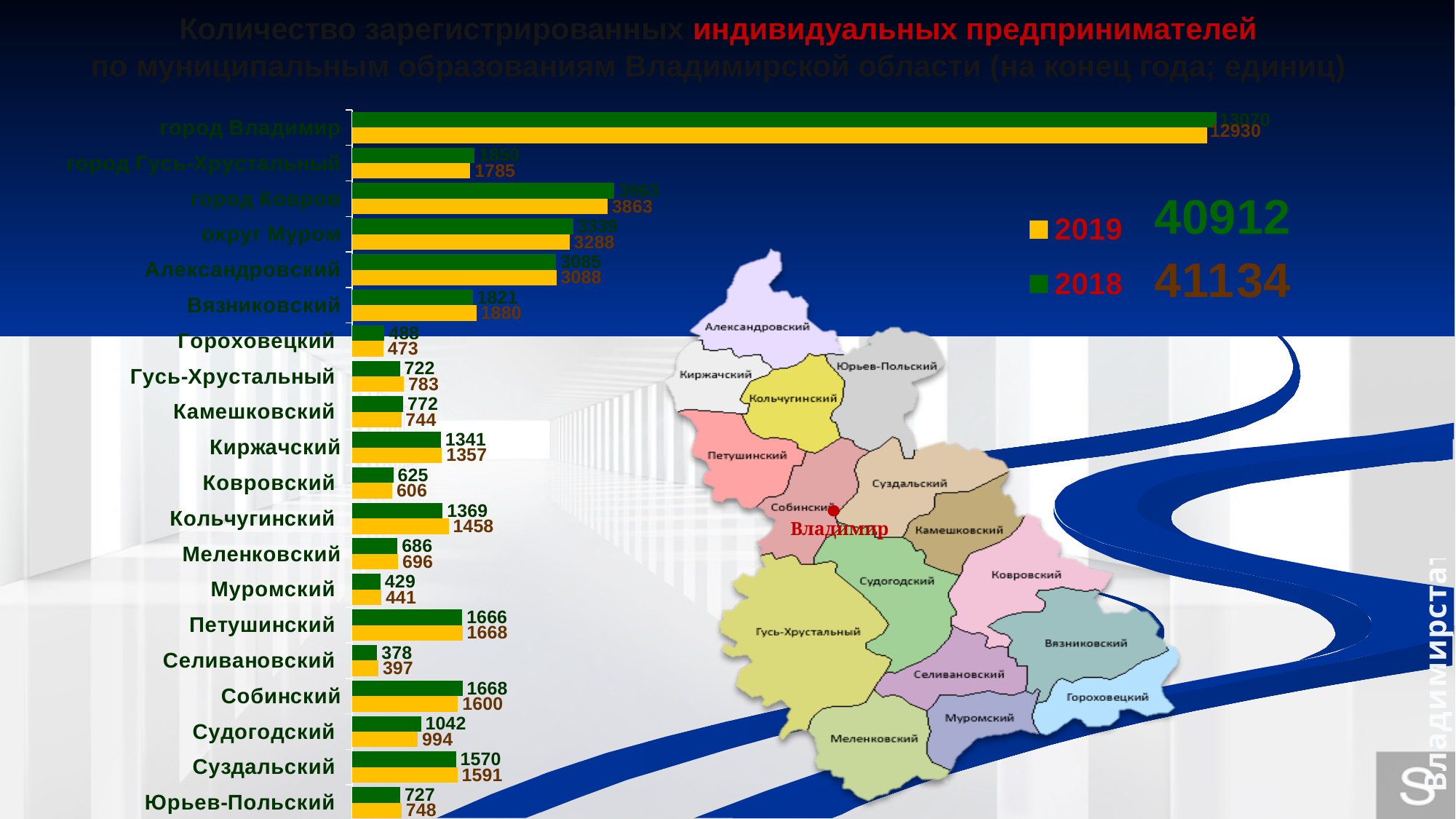
How many municipalities (categories) are plotted in the chart? 20 Which municipality has the highest 2018 value? город Владимир What kind of chart is shown on the slide? bar chart Which colour represents the 2019 series in the legend? yellow What is the 2019 value for город Владимир? 12930 Which is larger for Вязниковский: the 2018 value or the 2019 value? 2019 What is the difference between the 2018 and 2019 values for Собинский? 68 How many series does the legend list? 2 Which municipality has the lowest 2019 value? Селивановский What is the 2018 value for Судогодский? 1042 What is the 2019 value for Кольчугинский? 1458 What is the 2018 value for город Ковров? 3963